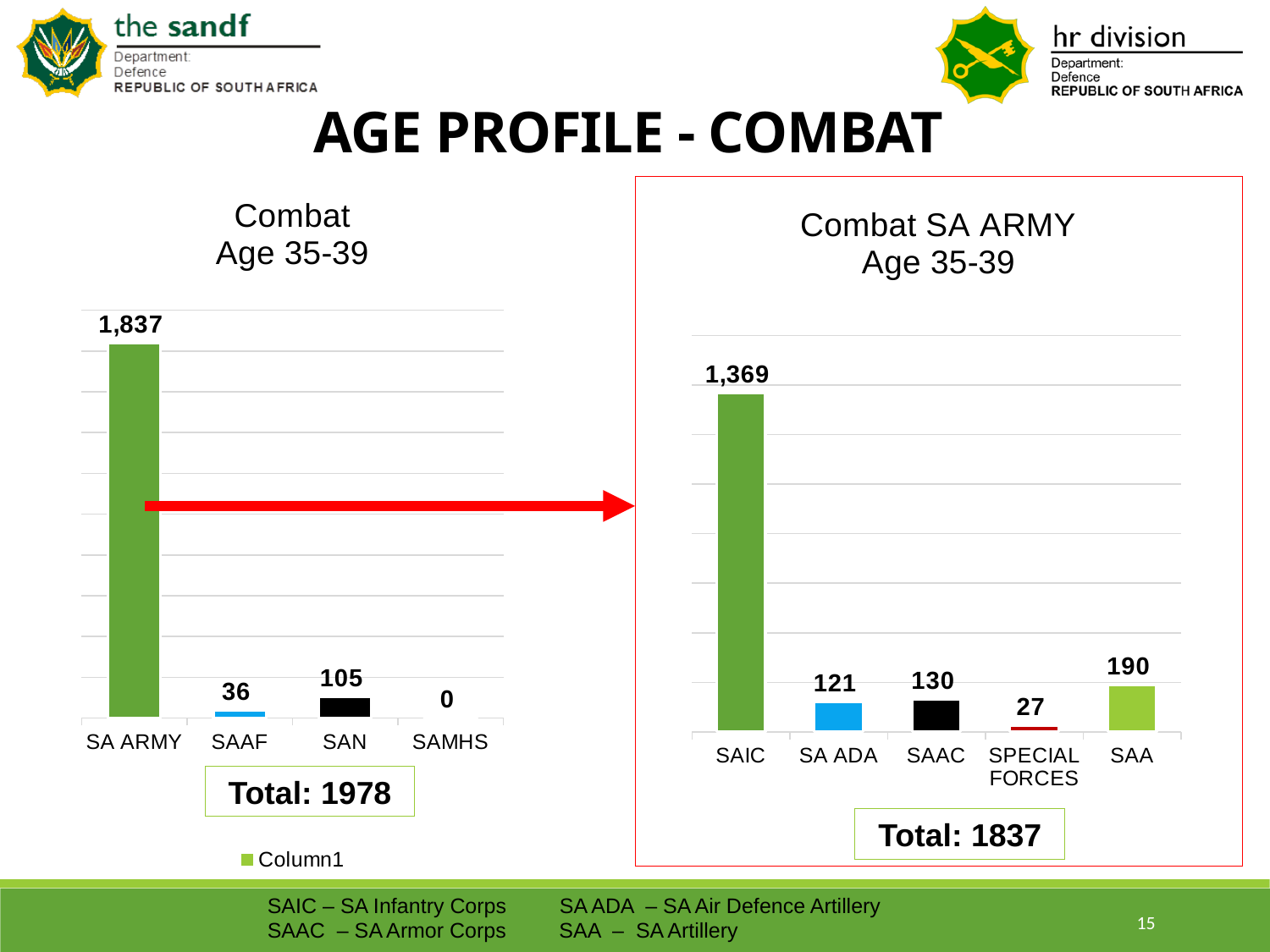
In the 'Combat Age 35-39' chart, which category has the lowest value? SAMHS In the 'Combat Age 35-39' chart, what is the legend entry shown below the chart? Column1 In the 'Combat SA ARMY Age 35-39' chart, which is larger, the value for SAA or the value for SAAC? SAA In the 'Combat SA ARMY Age 35-39' chart, what is the value for SAIC? 1,369 In the 'Combat Age 35-39' chart, how many categories are shown on the x axis? 4 In the 'Combat Age 35-39' chart, what is the value for SA ARMY? 1,837 In the 'Combat SA ARMY Age 35-39' chart, what is the difference between the values for SAA and SA ADA? 69 In the 'Combat SA ARMY Age 35-39' chart, what is the value for SPECIAL FORCES? 27 In the 'Combat Age 35-39' chart, what is the difference between the values for SAN and SAAF? 69 In the 'Combat SA ARMY Age 35-39' chart, which category has the highest value? SAIC In the 'Combat Age 35-39' chart, what is the value for SAN? 105 What kind of chart is the 'Combat SA ARMY Age 35-39' chart? Bar chart